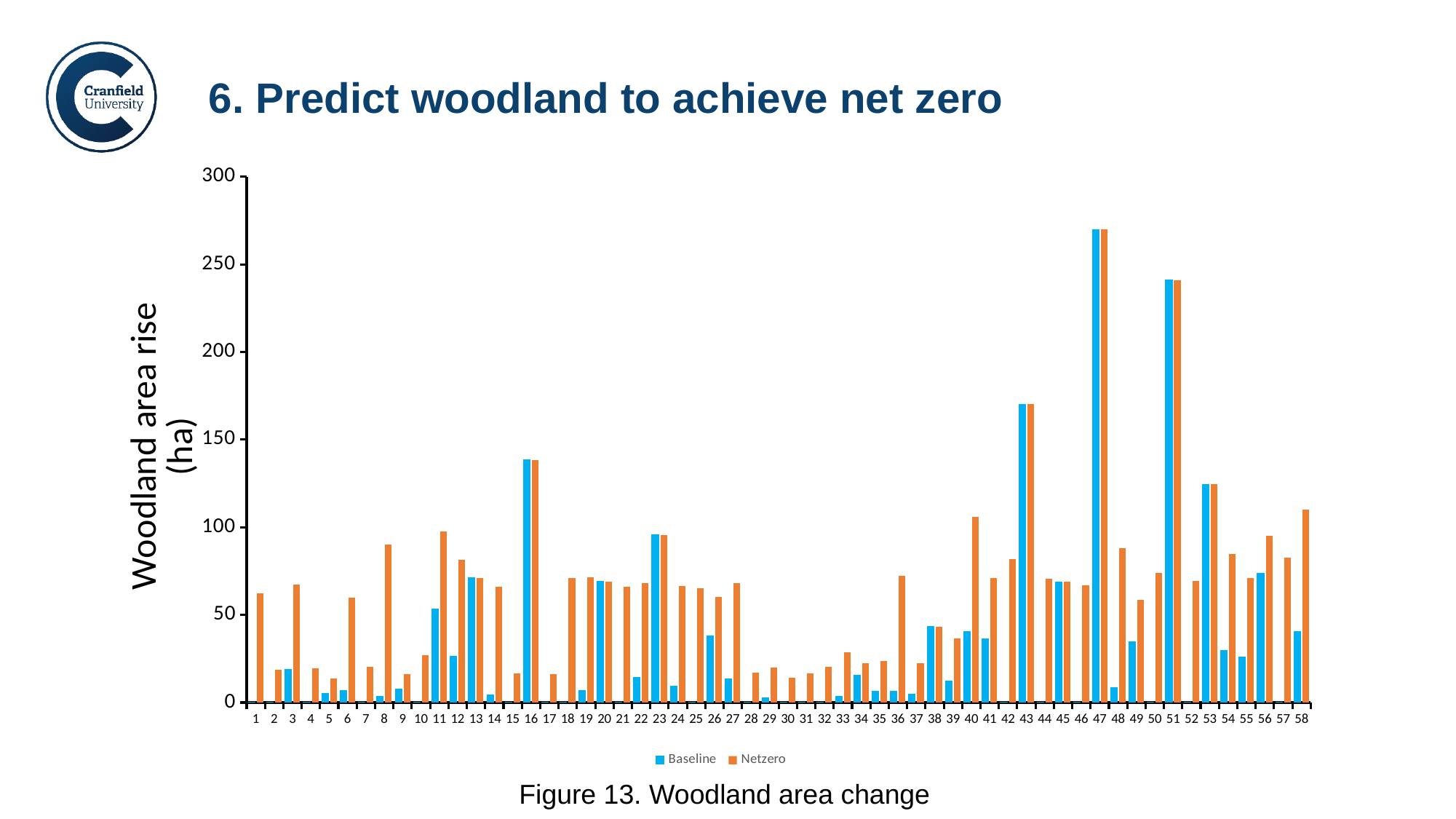
For category 40, which series has the larger value, Baseline or Netzero? Netzero How many categories are shown along the x axis? 58 What kind of chart is shown on the slide? bar chart Is the Netzero value for category 51 greater or less than 200? greater Is the Baseline value for category 43 greater or less than 150? greater What is the label on the y axis? Woodland area rise (ha) Which has the larger Baseline value, category 47 or category 51? 47 Which category has the highest Netzero value? 47 How many series does the legend list? 2 Which category has the highest Baseline value? 47 Is the Netzero value for category 16 greater or less than 150? less